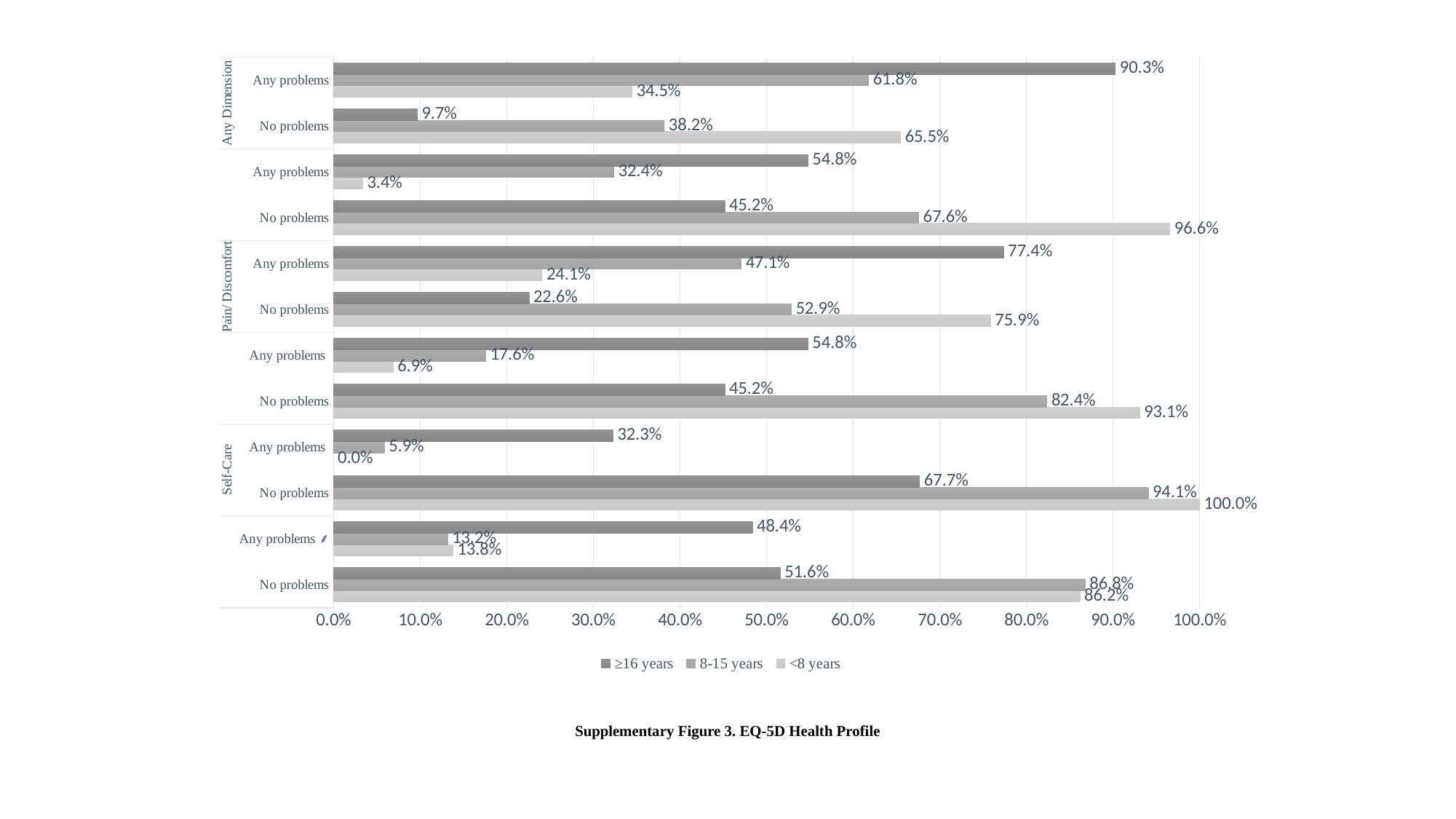
What is the difference between the ≥16 years and 8-15 years values for 'Any problems' in the Any Dimension group? 28.5% What type of chart is shown on the slide? bar chart What is the value for ≥16 years for 'Any problems' in the Any Dimension group? 90.3% How many series does the legend list? 3 For 'No problems' in the Self-Care group, which is larger: the 8-15 years value or the ≥16 years value? 8-15 years Is the value for <8 years for 'Any problems' in the Pain/Discomfort group greater or less than 30.0%? less What is the value for 8-15 years for 'Any problems' in the Pain/Discomfort group? 47.1% Which age group has the lowest value for 'No problems' in the Pain/Discomfort group? ≥16 years What is the caption of the figure shown on the slide? Supplementary Figure 3. EQ-5D Health Profile Which age group has the highest value for 'Any problems' in the Self-Care group? ≥16 years What is the value for <8 years for 'No problems' in the Any Dimension group? 65.5% What is the value for <8 years for 'No problems' in the Self-Care group? 100.0%